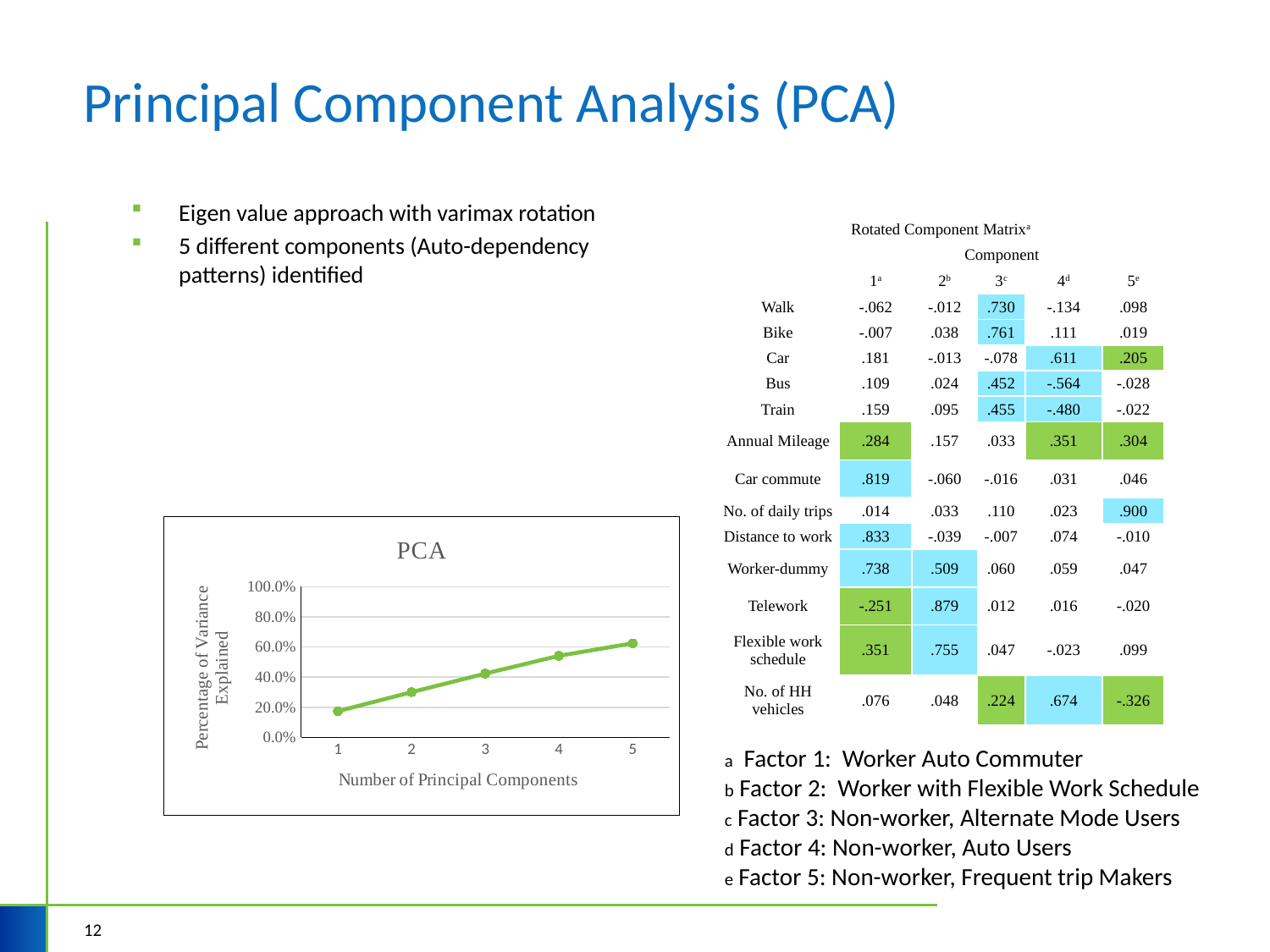
What is the label of the y axis on the PCA chart? Percentage of Variance Explained On the PCA chart, is the percentage of variance explained for 2 principal components greater or less than 40.0%? less Do the values on the PCA chart rise or fall as the number of principal components increases from 1 to 5? rise Which number of principal components has the highest percentage of variance explained on the PCA chart? 5 How many points are plotted on the PCA line chart? 5 What is the title of the line chart on the slide? PCA On the PCA chart, is the percentage of variance explained for 5 principal components greater or less than 80.0%? less On the PCA chart, is the percentage of variance explained for 4 principal components greater or less than 40.0%? greater Which number of principal components has the lowest percentage of variance explained on the PCA chart? 1 On the PCA chart, which has a higher percentage of variance explained: 3 principal components or 5 principal components? 5 principal components What kind of chart is the PCA chart on the slide? line chart